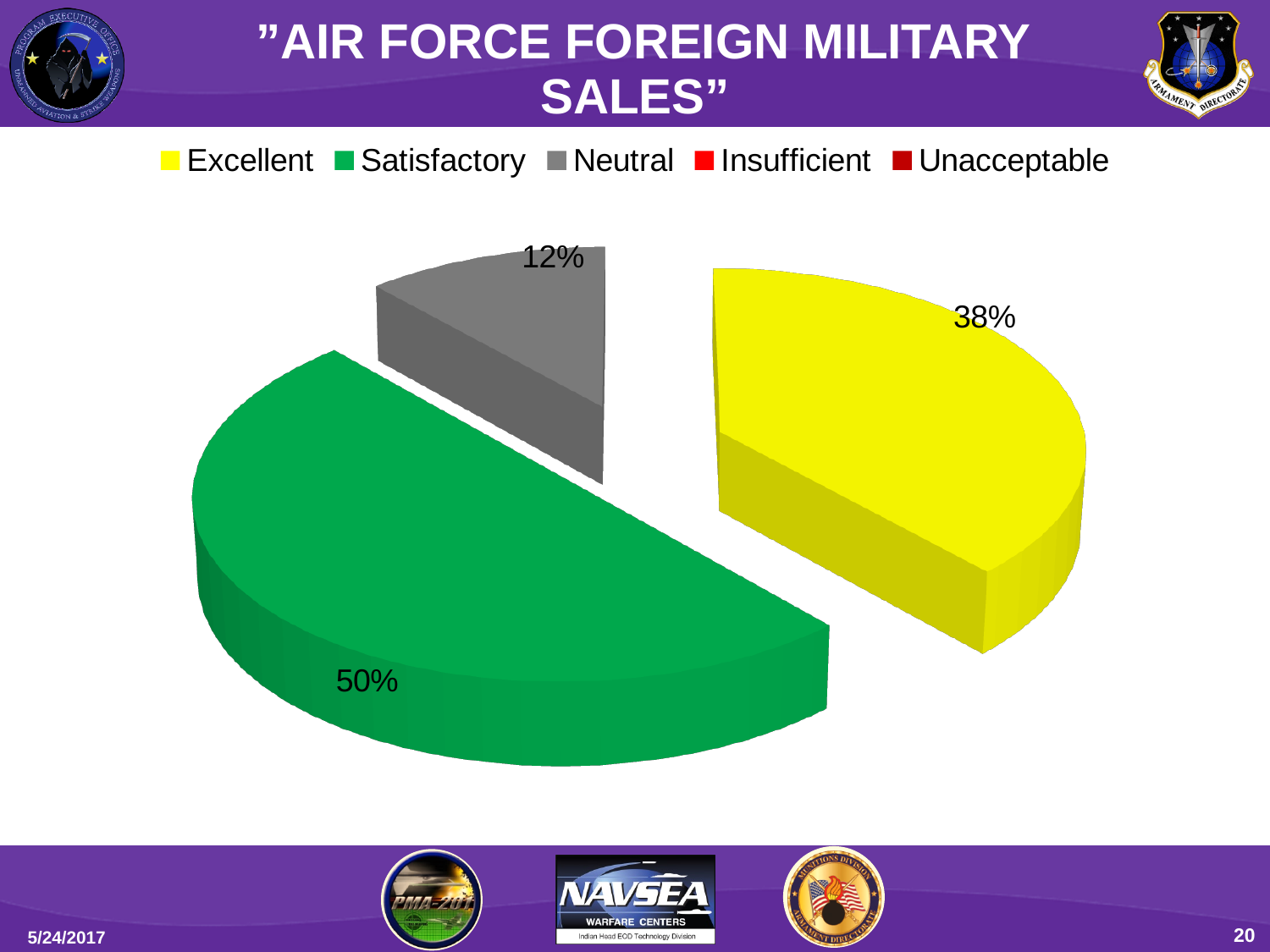
Which category has the largest slice of the pie? Satisfactory What kind of chart is shown on the slide? Pie chart Which of the visible slices is the smallest? Neutral What is the difference in percentage points between the Excellent and Neutral slices? 26 What is the title of the chart? "AIR FORCE FOREIGN MILITARY SALES" Which is larger, the Excellent slice or the Neutral slice? Excellent What share of the pie does the Excellent slice represent? 38% What is the difference in percentage points between the Satisfactory and Excellent slices? 12 What share of the pie does the Satisfactory slice represent? 50% What colour is the Satisfactory slice? Green What share of the pie does the Neutral slice represent? 12% How many categories does the legend list? 5